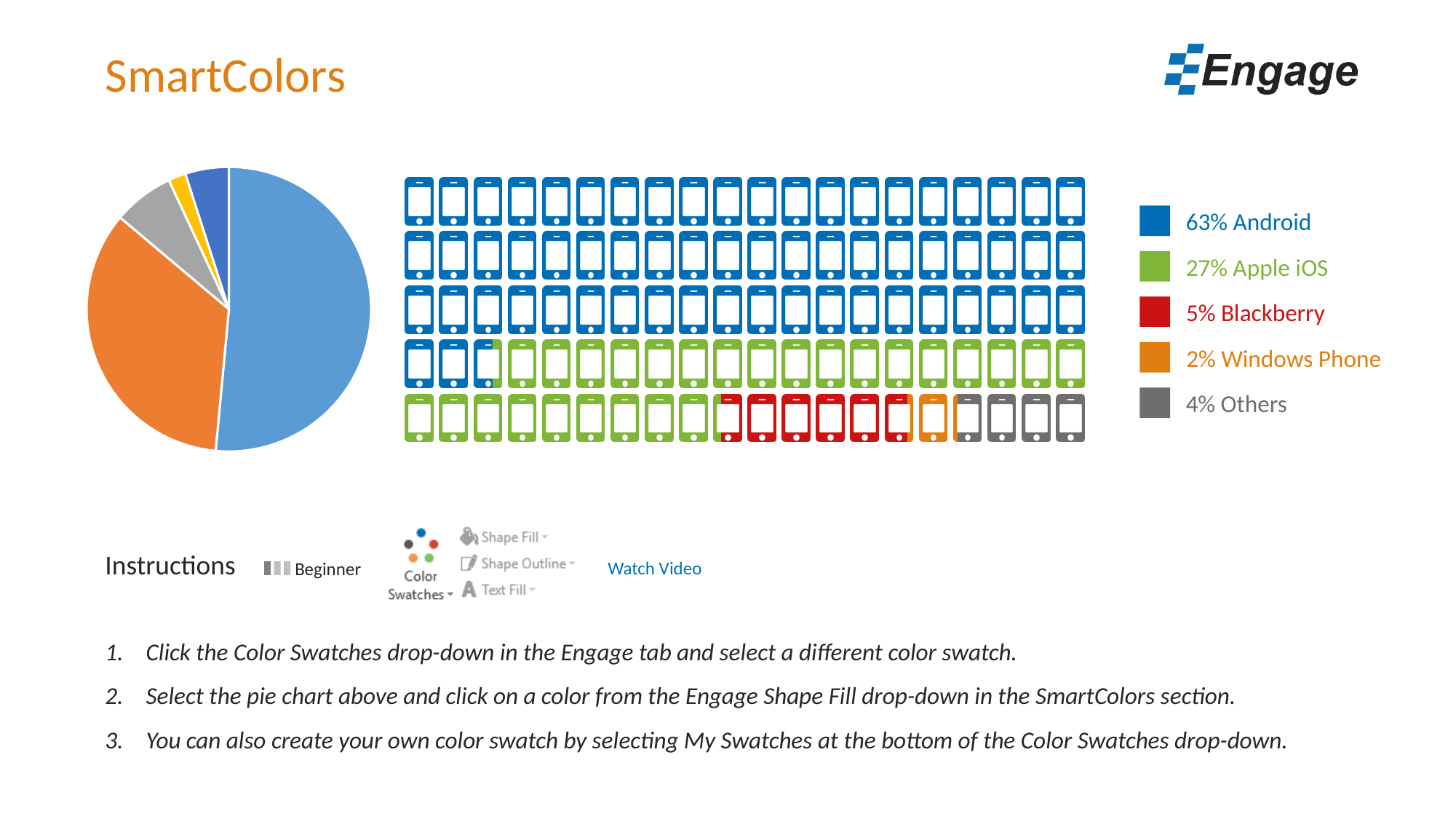
In the phone icon chart, what percentage is shown for Windows Phone? 2% In the phone icon chart, what percentage is shown for Apple iOS? 27% In the phone icon chart, what percentage is shown for Android? 63% In the phone icon chart, which category has the lowest percentage? Windows Phone In the phone icon chart, which has a larger share, Blackberry or Others? Blackberry What type of chart is shown on the left side of the slide? Pie chart In the phone icon chart, what is the difference in percentage points between Android and Apple iOS? 36 In the phone icon chart, which category has the highest percentage? Android In the legend of the phone icon chart, what colour represents Apple iOS? Green In the phone icon chart, what is the combined percentage of Blackberry, Windows Phone and Others? 11% In the phone icon chart, what percentage is shown for Blackberry? 5% How many categories does the legend of the phone icon chart list? 5